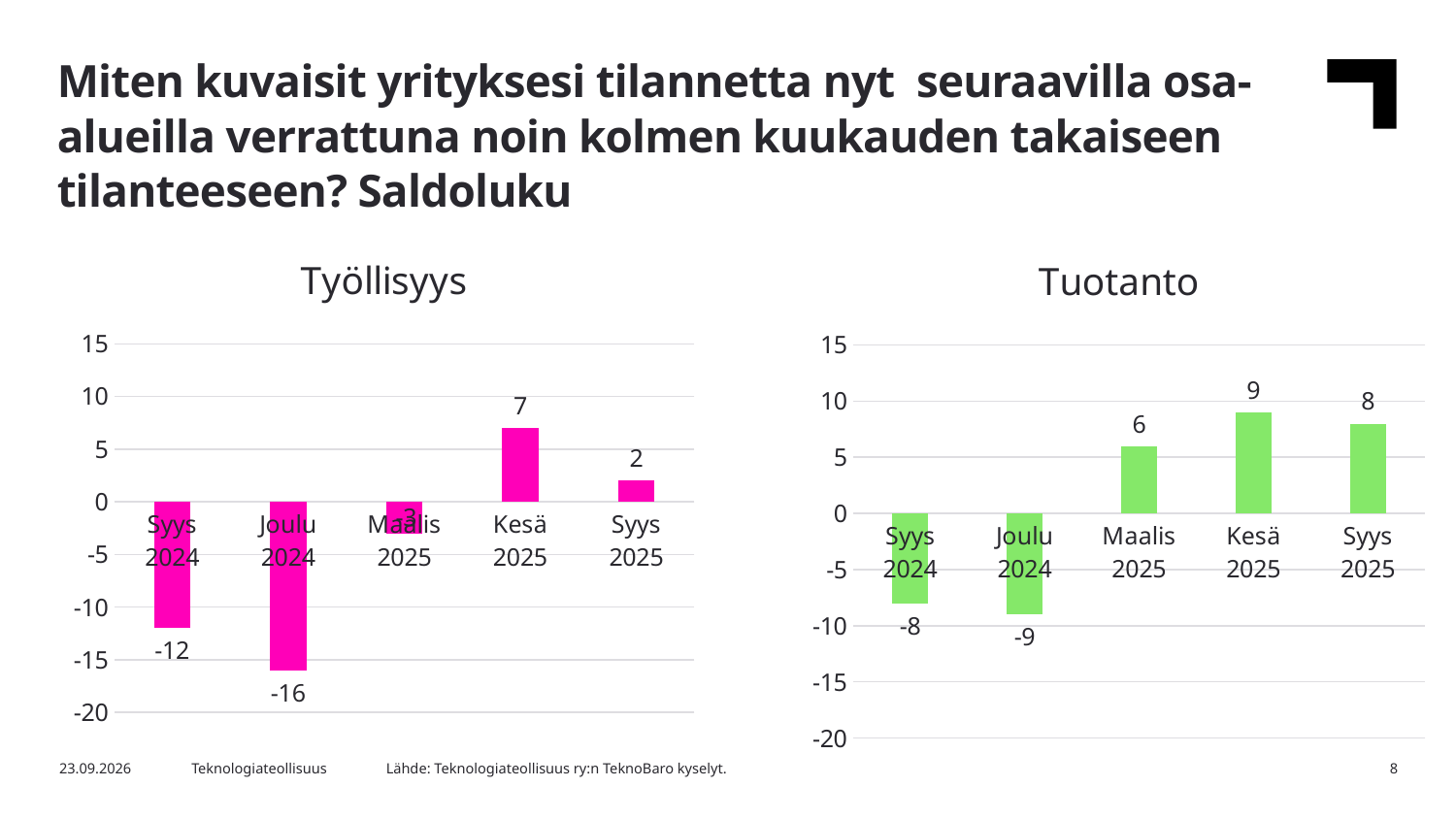
In the Tuotanto chart, which period has the highest value? Kesä 2025 In the Työllisyys chart, what is the value for Joulu 2024? -16 In the Työllisyys chart, which period has the lowest value? Joulu 2024 In the Tuotanto chart, is the value for Joulu 2024 greater or less than -5? less What kind of chart is the Työllisyys chart? Bar chart In the Tuotanto chart, what is the value for Maalis 2025? 6 In the Tuotanto chart, what is the value for Syys 2024? -8 In the Työllisyys chart, what is the difference between the values for Kesä 2025 and Syys 2025? 5 In the Työllisyys chart, which is larger, the value for Syys 2024 or the value for Joulu 2024? Syys 2024 How many periods are shown on the x axis of the Tuotanto chart? 5 In the Työllisyys chart, what is the value for Kesä 2025? 7 In the Tuotanto chart, what is the difference between the values for Kesä 2025 and Syys 2025? 1